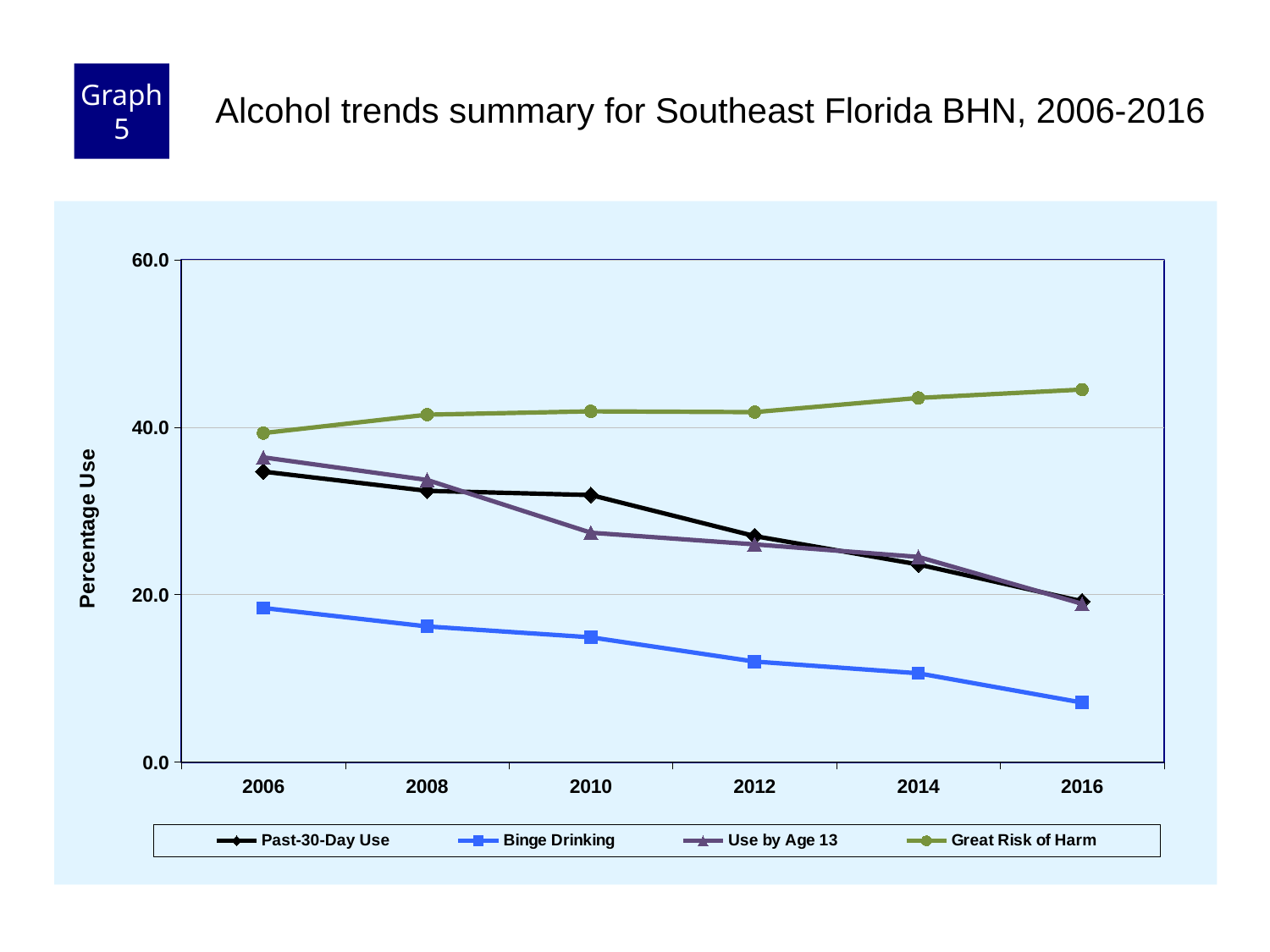
What kind of chart is shown on the slide? line chart Is the value for Binge Drinking in 2016 greater or less than 20.0? less In 2010, which is larger: Past-30-Day Use or Use by Age 13? Past-30-Day Use Which series has the lowest value in 2006? Binge Drinking Does the Binge Drinking line rise or fall from 2006 to 2016? fall What is the label on the y axis? Percentage Use Is the value for Great Risk of Harm in 2016 greater or less than 40.0? greater Does the Great Risk of Harm line rise or fall from 2006 to 2016? rise How many series does the legend list? 4 Is the value for Use by Age 13 in 2010 greater or less than 20.0? greater Which series has the highest value in 2016? Great Risk of Harm How many years are plotted along the x axis? 6